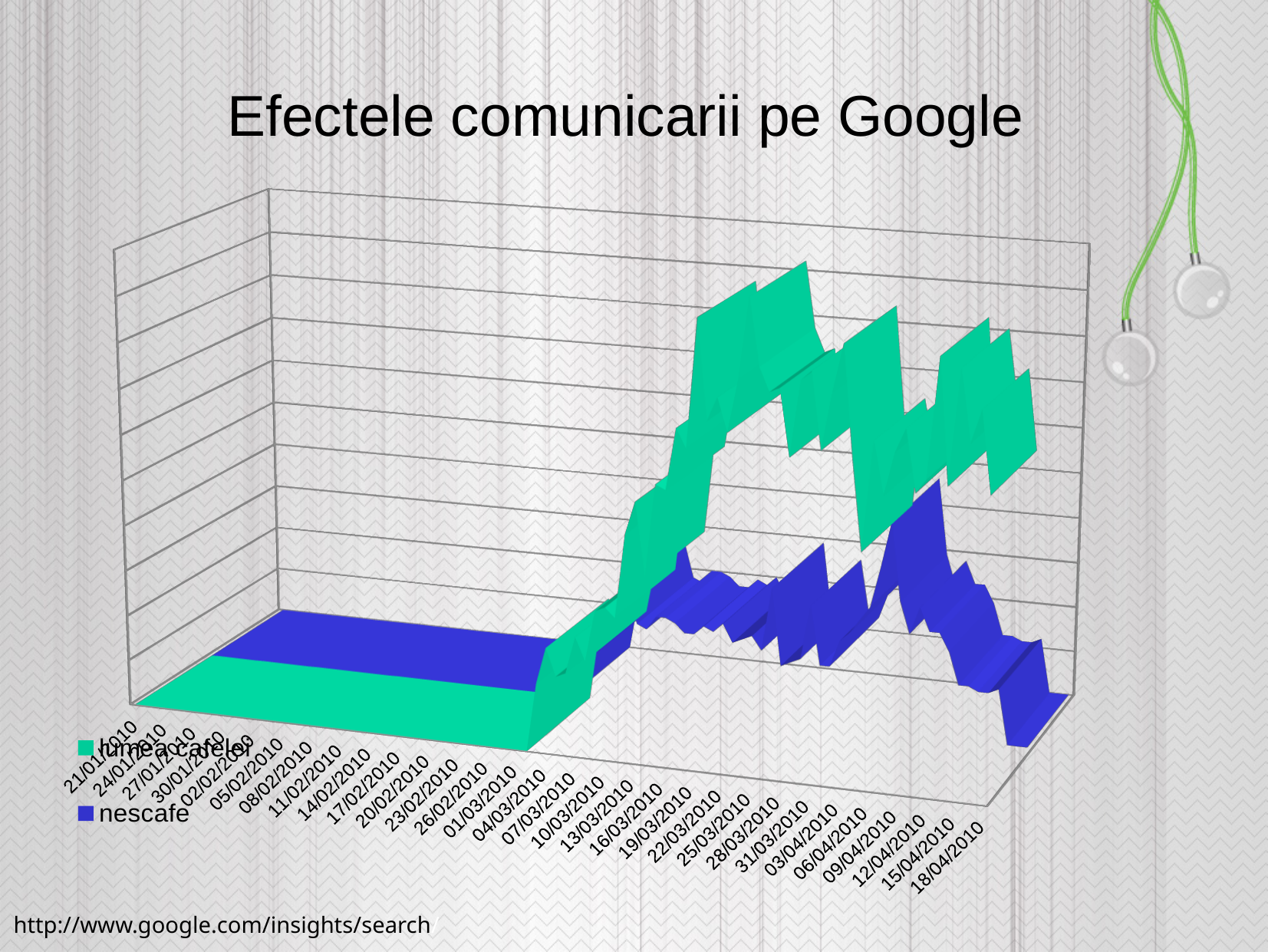
What is the last date shown on the x axis? 18/04/2010 What kind of chart is shown on the slide? 3D line chart At 18/04/2010, which series has the larger value, lumea cafelei or nescafe? lumea cafelei Do the values for both series stay flat or rise between 21/01/2010 and 20/02/2010? Stay flat How many series does the legend list? 2 Which series is shown in blue in the chart? nescafe Do the values for lumea cafelei rise or fall between 26/02/2010 and 10/03/2010? Rise Which series reaches the higher peak value in the chart? lumea cafelei Do the values for nescafe rise or fall between 03/04/2010 and 18/04/2010? Fall What is the title of the chart? Efectele comunicarii pe Google